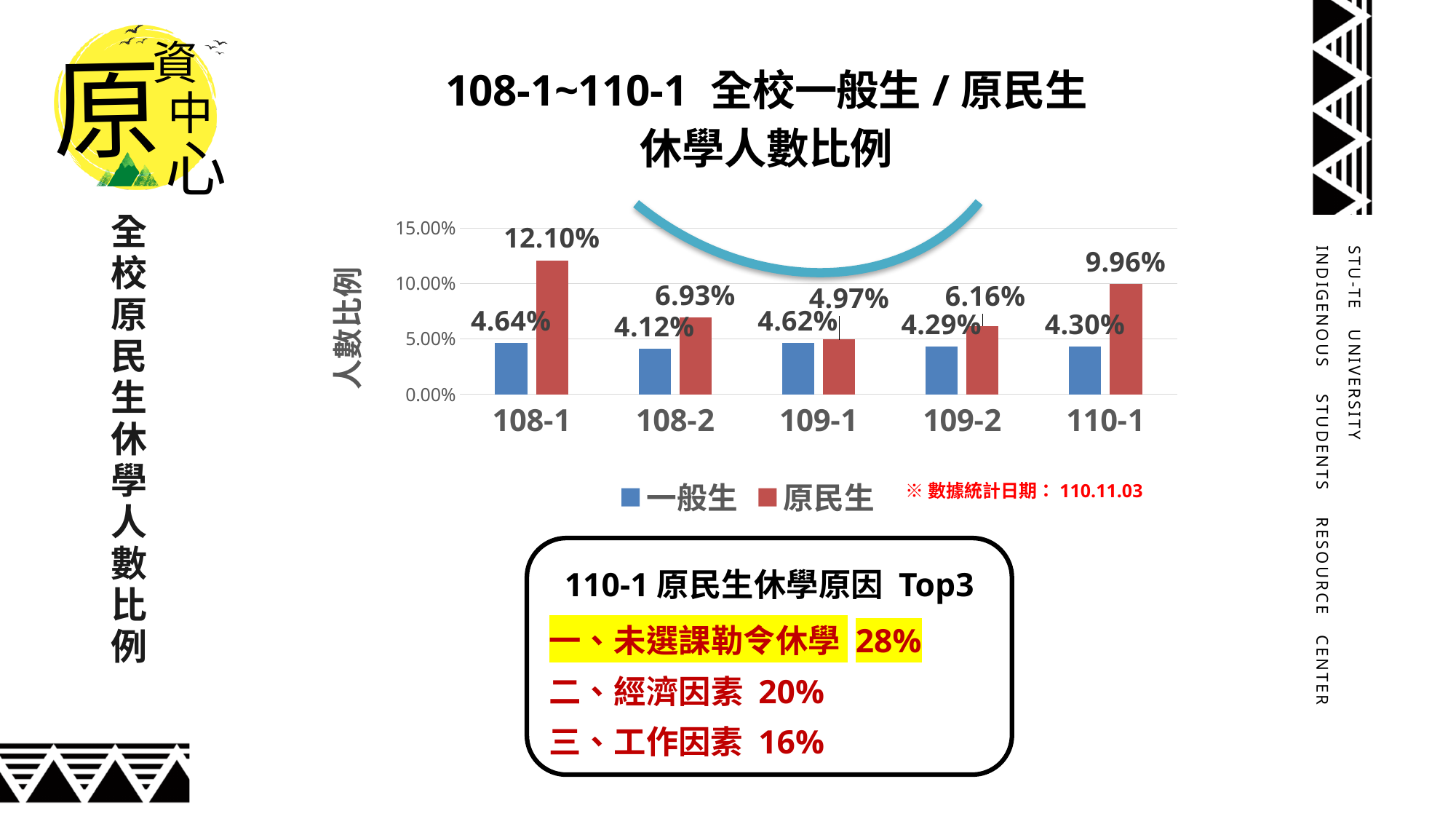
How many semester categories are shown on the x axis? 5 What is the difference between the 原民生 and 一般生 values in 110-1? 5.66% What type of chart is shown on the slide? Bar chart What is the value for 原民生 in 108-1? 12.10% Which series is shown in red in the legend? 原民生 In which semester is the 一般生 value lowest? 108-2 What is the value for 一般生 in 110-1? 4.30% Is the value for 原民生 in 108-1 greater or less than 10.00%? greater How many series does the legend list? 2 Which is larger in 109-2, the 一般生 value or the 原民生 value? 原民生 What is the value for 原民生 in 109-1? 4.97% In which semester is the 原民生 value highest? 108-1